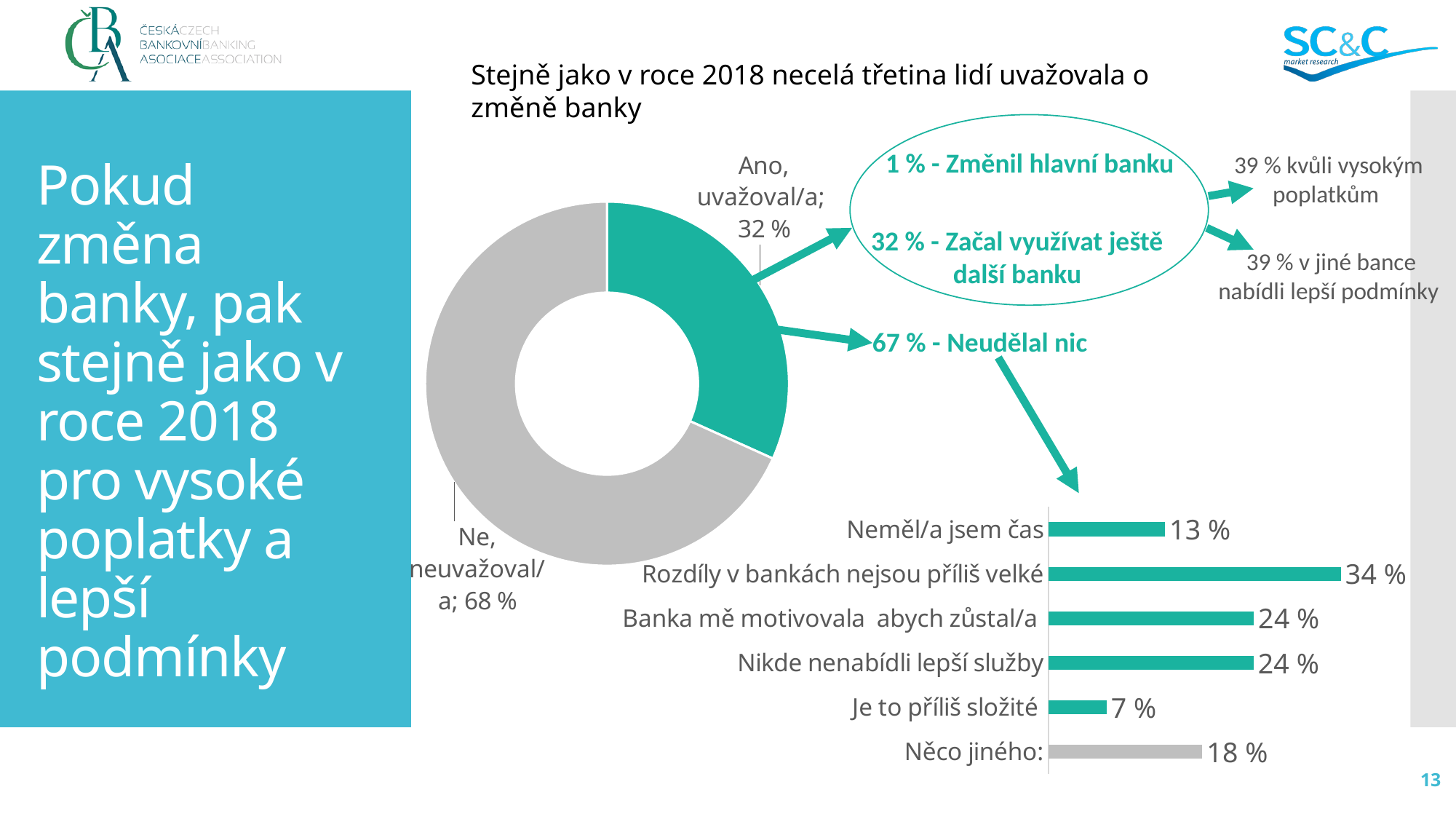
In the bar chart at the bottom right, which category has the lowest value? Je to příliš složité In the bar chart at the bottom right, what is the value for "Je to příliš složité"? 7 % In the donut chart on the left, what share is labelled "Ano, uvažoval/a"? 32 % What kind of chart is the chart on the left of the slide? Donut (pie) chart How many categories are shown in the bar chart at the bottom right? 6 How many slices does the donut chart on the left have? 2 In the donut chart on the left, which slice is larger, "Ano, uvažoval/a" or "Ne, neuvažoval/a"? Ne, neuvažoval/a In the donut chart on the left, what share is labelled "Ne, neuvažoval/a"? 68 % In the bar chart at the bottom right, which category has the highest value? Rozdíly v bankách nejsou příliš velké In the bar chart at the bottom right, which bar is shown in grey rather than teal? Něco jiného: In the bar chart at the bottom right, what is the difference between "Rozdíly v bankách nejsou příliš velké" and "Neměl/a jsem čas"? 21 % In the bar chart at the bottom right, what is the value for "Rozdíly v bankách nejsou příliš velké"? 34 %